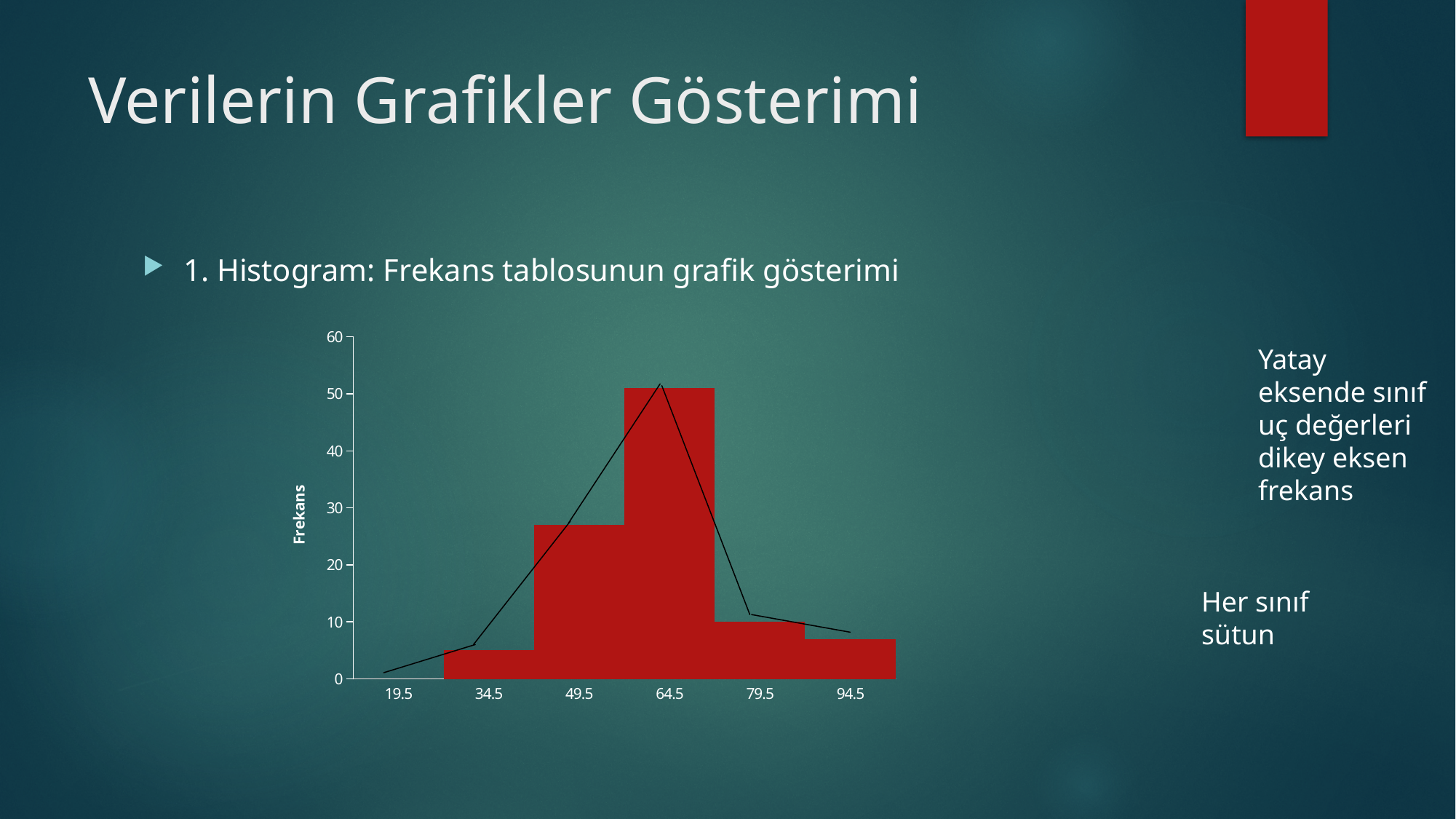
Is the frequency for the bar at 49.5 greater or less than 30? less What colour are the bars in the histogram? red Which x-axis class has the highest frequency? 64.5 Is the frequency for the bar at 94.5 greater or less than 10? less Which bar is taller, the one at 64.5 or the one at 49.5? 64.5 Is the frequency for the bar at 79.5 greater or less than 20? less What is the label of the vertical axis? Frekans How many bars does the histogram have? 5 What kind of chart is shown on the slide? bar chart (histogram) Which bar is taller, the one at 49.5 or the one at 79.5? 49.5